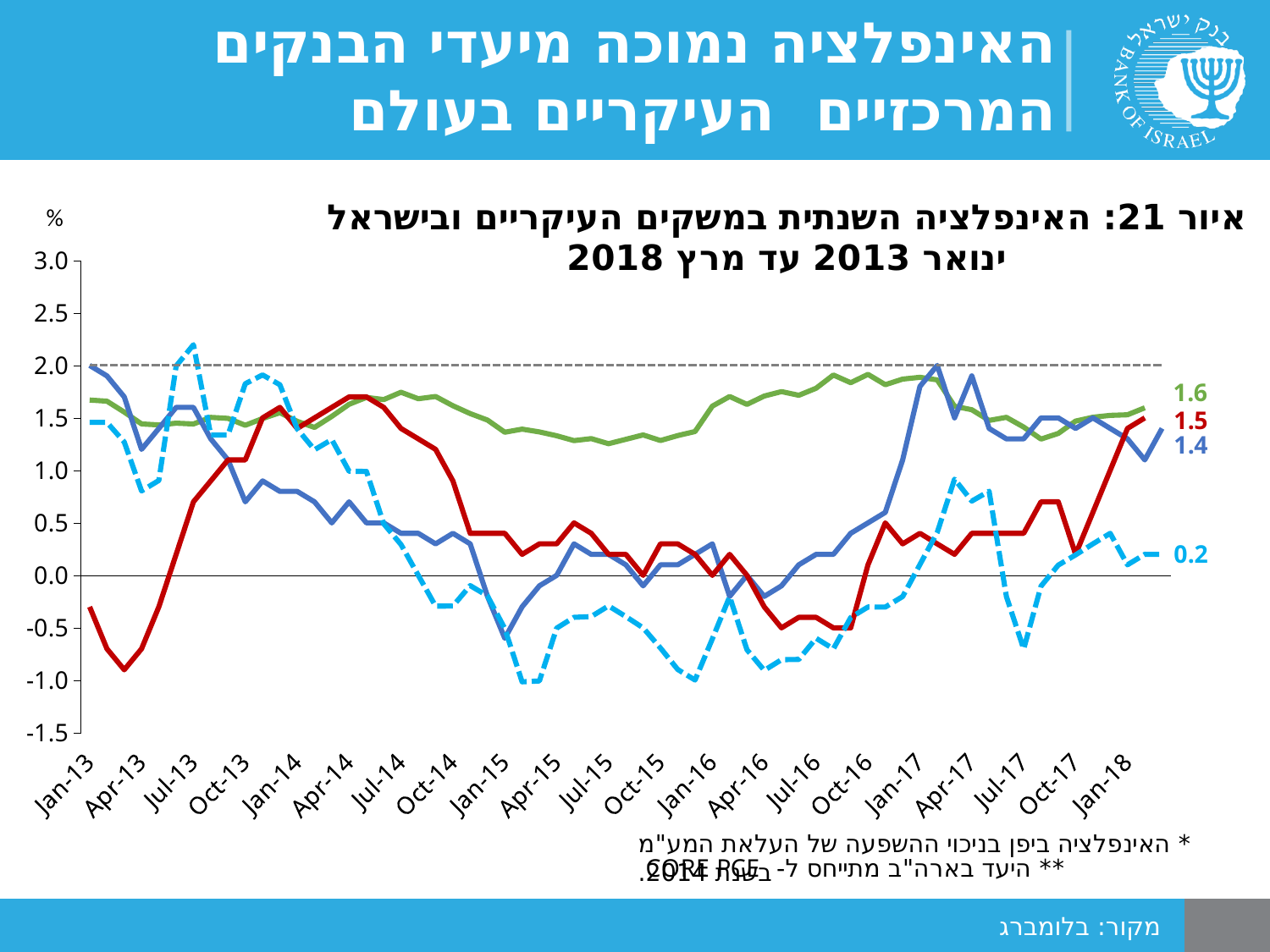
Which line ends at the lowest labelled value at the right edge of the chart? the dashed light-blue line (0.2) What is the final labelled value of the dashed light-blue line? 0.2 What is the final labelled value of the green line? 1.6 Which line ends at the highest labelled value at the right edge of the chart? the green line (1.6) What is the final labelled value of the red line? 1.5 Is the peak of the dashed light-blue line around Jul-13 greater or less than 2.0? greater What type of chart is shown on the slide? line chart What is the difference between the final labelled values of the green line (1.6) and the dashed light-blue line (0.2)? 1.4 Which is larger at the end of the chart: the red line's value or the solid blue line's value? the red line (1.5) Is the value of the red line around Apr-13 greater or less than -0.5? less What unit is shown at the top of the vertical axis? %